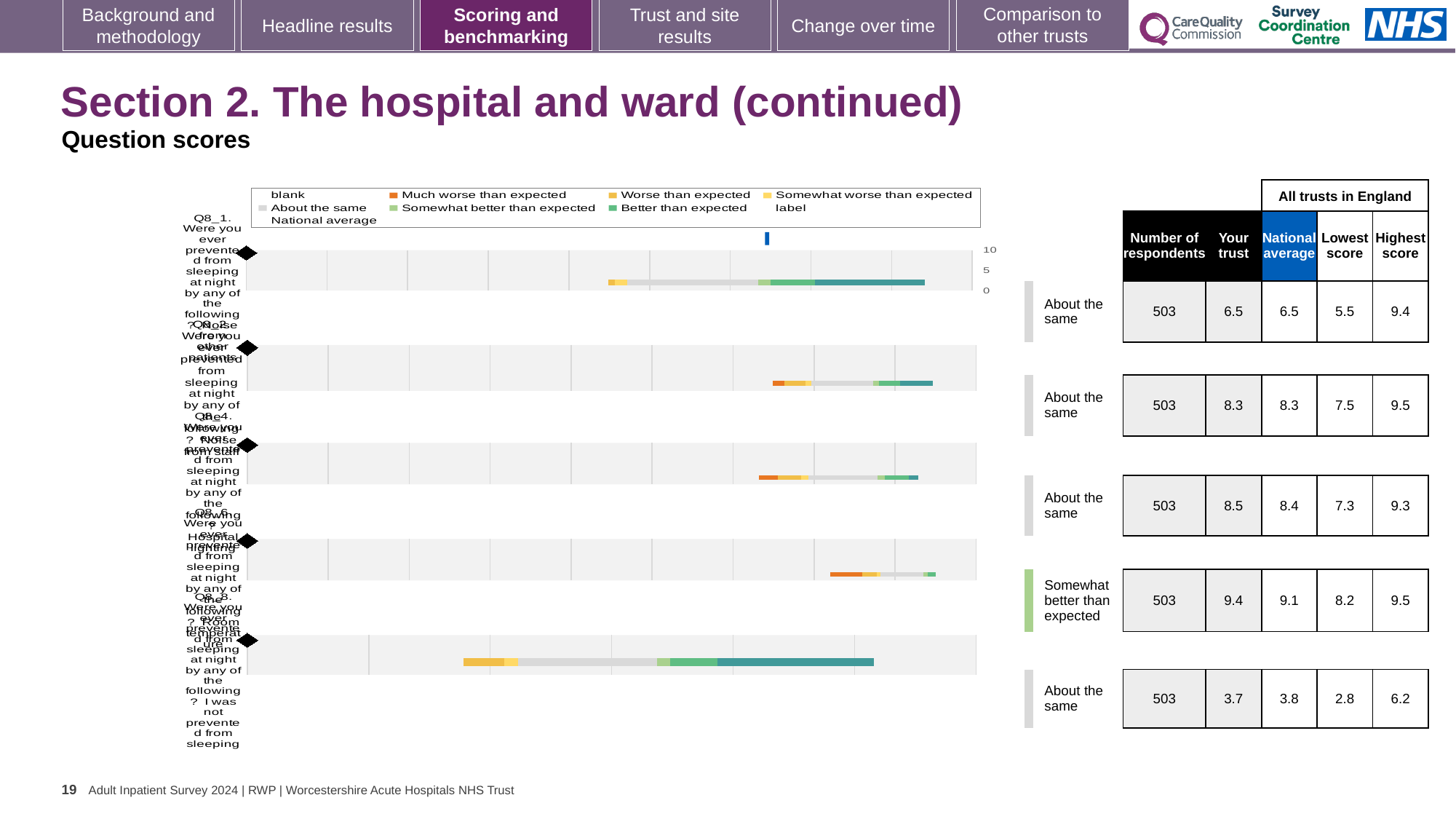
What kind of chart is shown on the slide? bar chart What is the highest score among all trusts in England for the second question row? 9.5 What is the national average for the fourth question row? 9.1 What is the 'Your trust' score for the fifth (bottom) question row? 3.7 Which question row has the lowest 'Your trust' score? the fifth (bottom) row What is the difference between the 'Your trust' score and the national average for the fourth question row? 0.3 How many question rows (bars) are plotted in the chart? 5 Which question row has the highest 'Your trust' score? the fourth row How many respondents are recorded for each question row? 503 Which benchmark category is shown for the fourth question row? Somewhat better than expected What is the 'Your trust' score for the first (top) question row? 6.5 Is the 'Your trust' score for the third question row larger or smaller than its national average? larger